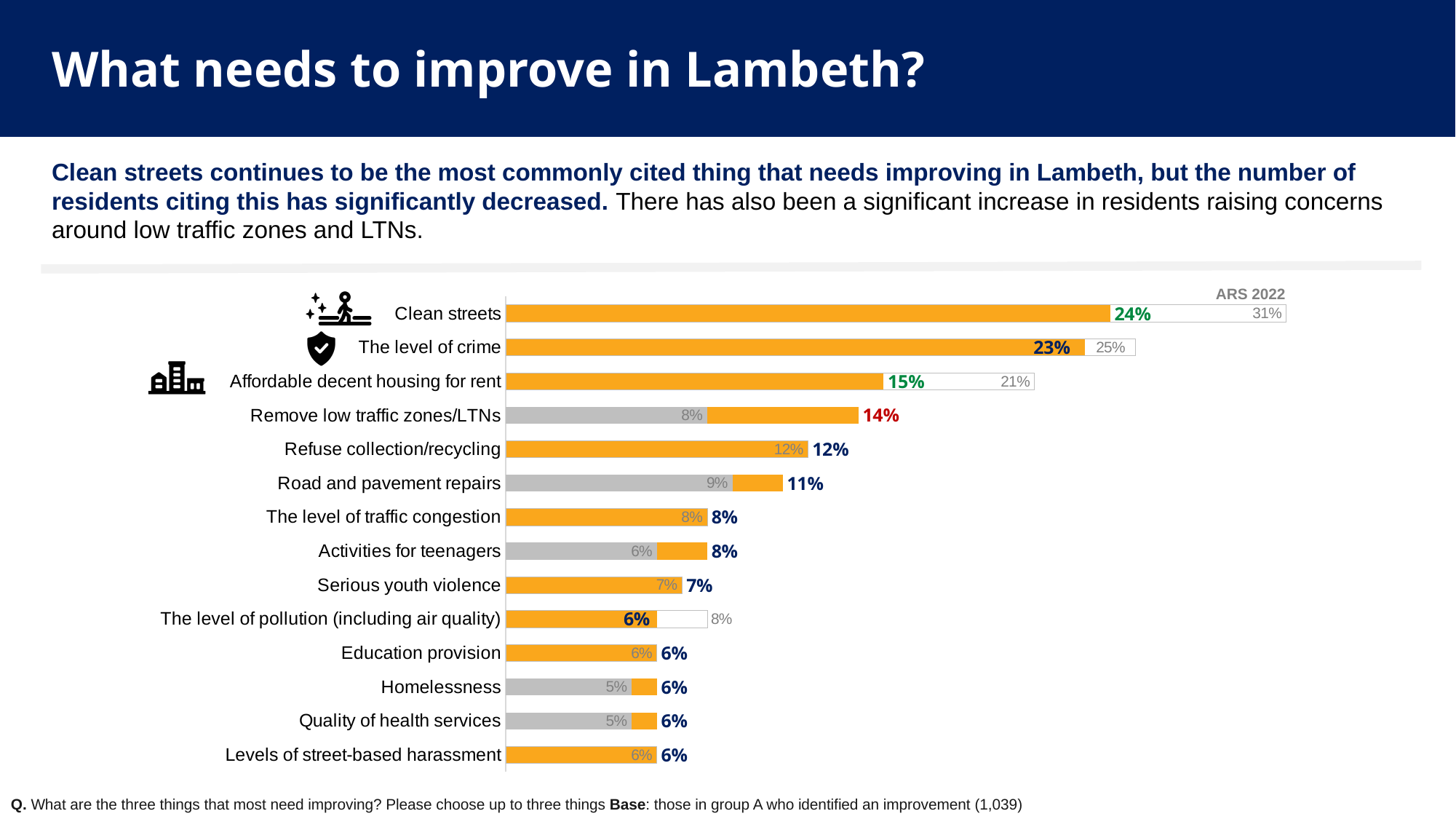
Which is larger: the current value for road and pavement repairs or its ARS 2022 value? The current value (11%) What percentage of residents cited clean streets as something that needs improving? 24% What is the label of the comparison year shown in grey on the chart? ARS 2022 What was the ARS 2022 value for clean streets? 31% Which is larger: the current value for the level of crime or for affordable decent housing for rent? The level of crime What is the difference between the current value for removing low traffic zones/LTNs and its ARS 2022 value? 6% What percentage cited removing low traffic zones/LTNs? 14% What is the difference between the current value for clean streets and its ARS 2022 value? 7% How many categories are shown in the chart? 14 What was the ARS 2022 value for affordable decent housing for rent? 21% What kind of chart is shown on the slide? Bar chart Which category has the highest current value? Clean streets